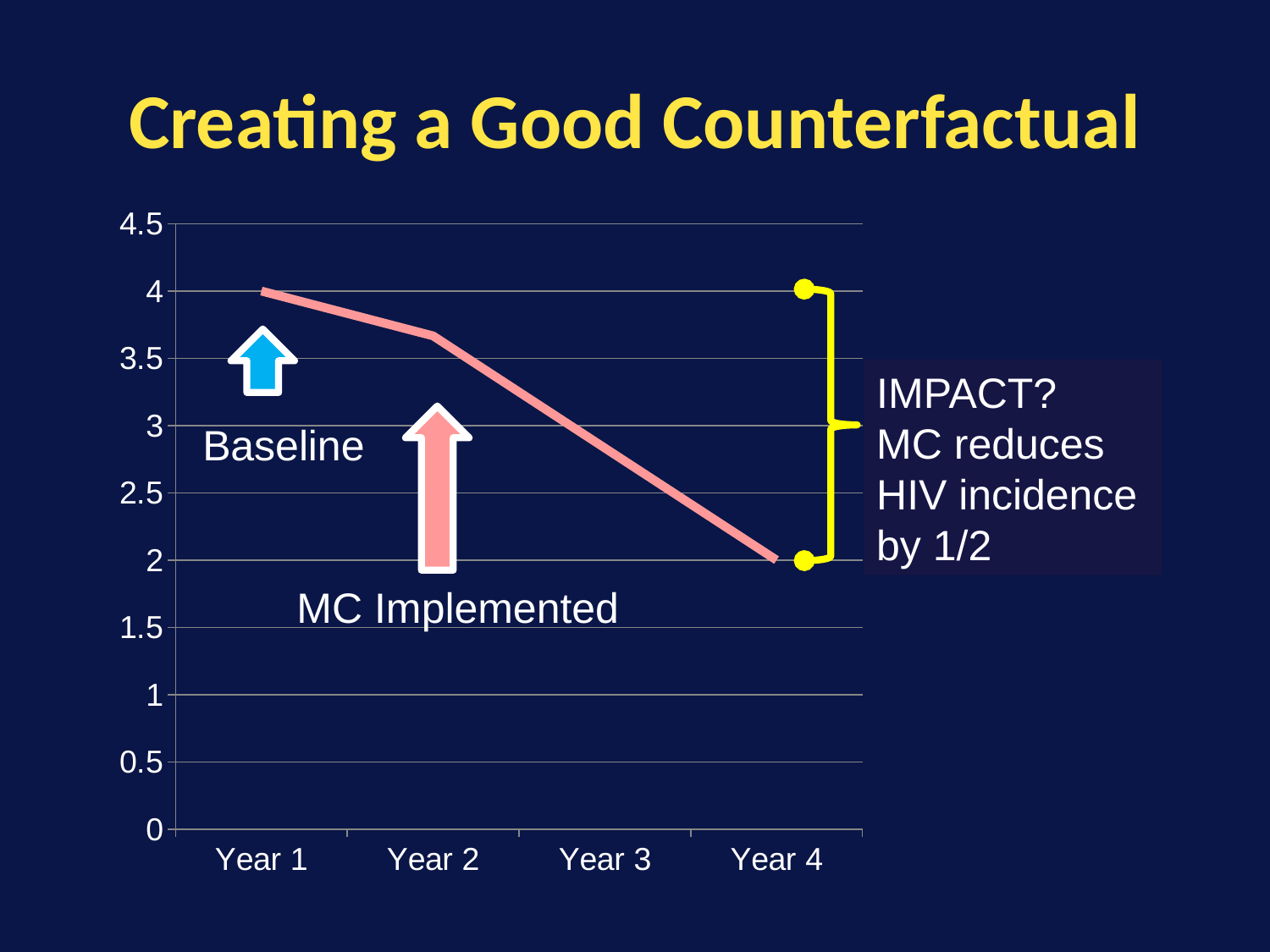
Which has the larger plotted value, Year 2 or Year 3? Year 2 What kind of chart is shown on the slide? line chart Is the value for Year 3 greater or less than 3? less What is the value plotted for Year 1? 4 Do the plotted values rise or fall from Year 1 to Year 4? fall Which year has the lowest plotted value? Year 4 What is the value plotted for Year 4? 2 Which year has the highest plotted value? Year 1 Is the value for Year 2 greater or less than 3.5? greater What is the difference between the value for Year 1 and the value for Year 4? 2 How many years are plotted along the x axis? 4 What is the title of the slide containing the chart? Creating a Good Counterfactual